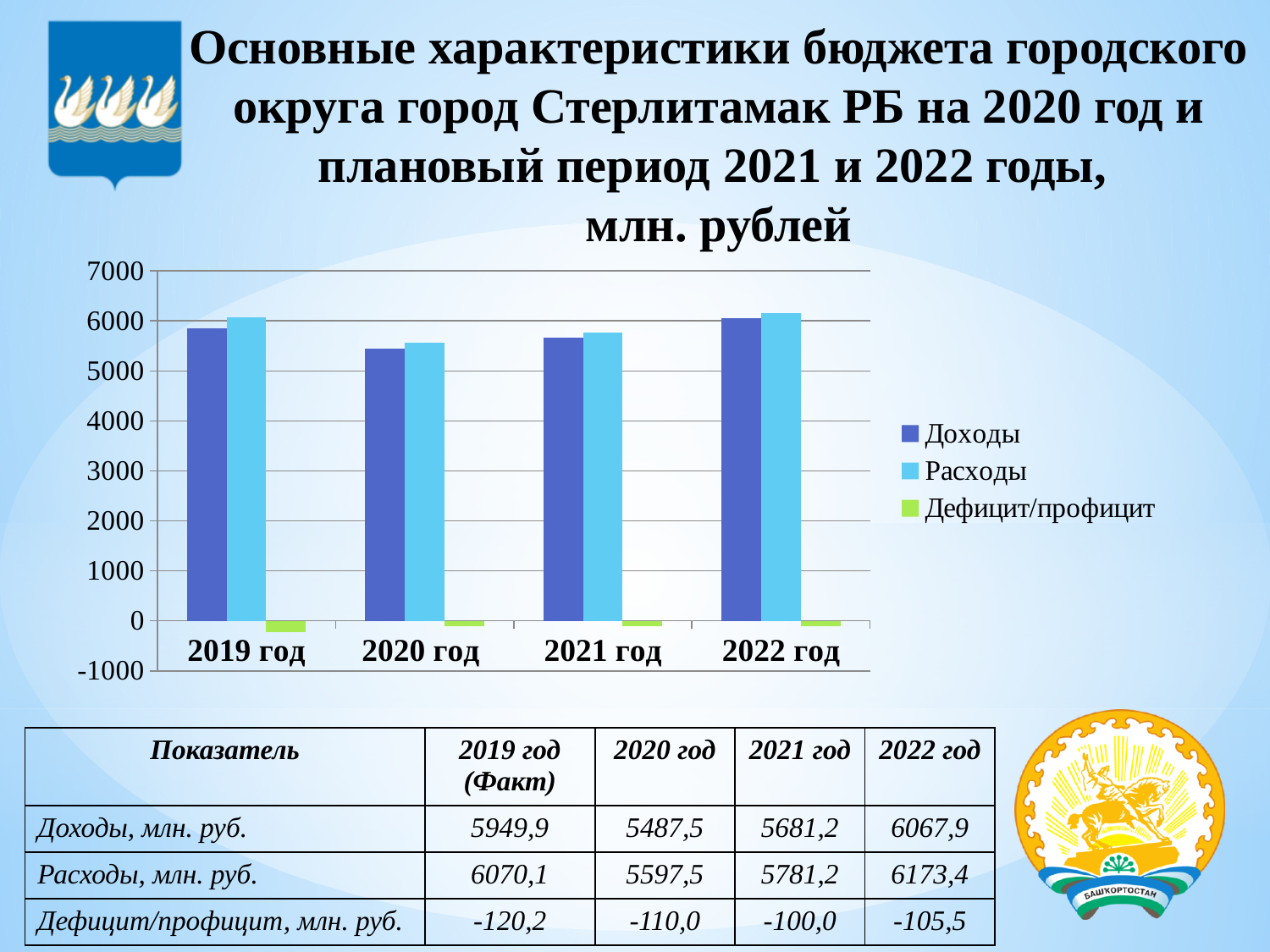
What is the Доходы value for 2021 год, as given in the table under the chart? 5681,2 In which year is the Доходы bar the highest? 2022 год Is the Расходы value for 2022 год greater or less than 6000? greater In which year is the Доходы bar the lowest? 2020 год In which year is the Расходы bar the highest? 2022 год How many series does the chart legend list? 3 By how much do Расходы exceed Доходы in 2020 год, according to the table values? 110,0 Do the Доходы bars rise or fall from 2020 год to 2022 год? rise Is the Доходы value for 2020 год greater or less than 6000? less What kind of chart is shown on the slide? bar chart For 2019 год, which is larger: Доходы or Расходы? Расходы How many year categories are shown on the x axis of the chart? 4